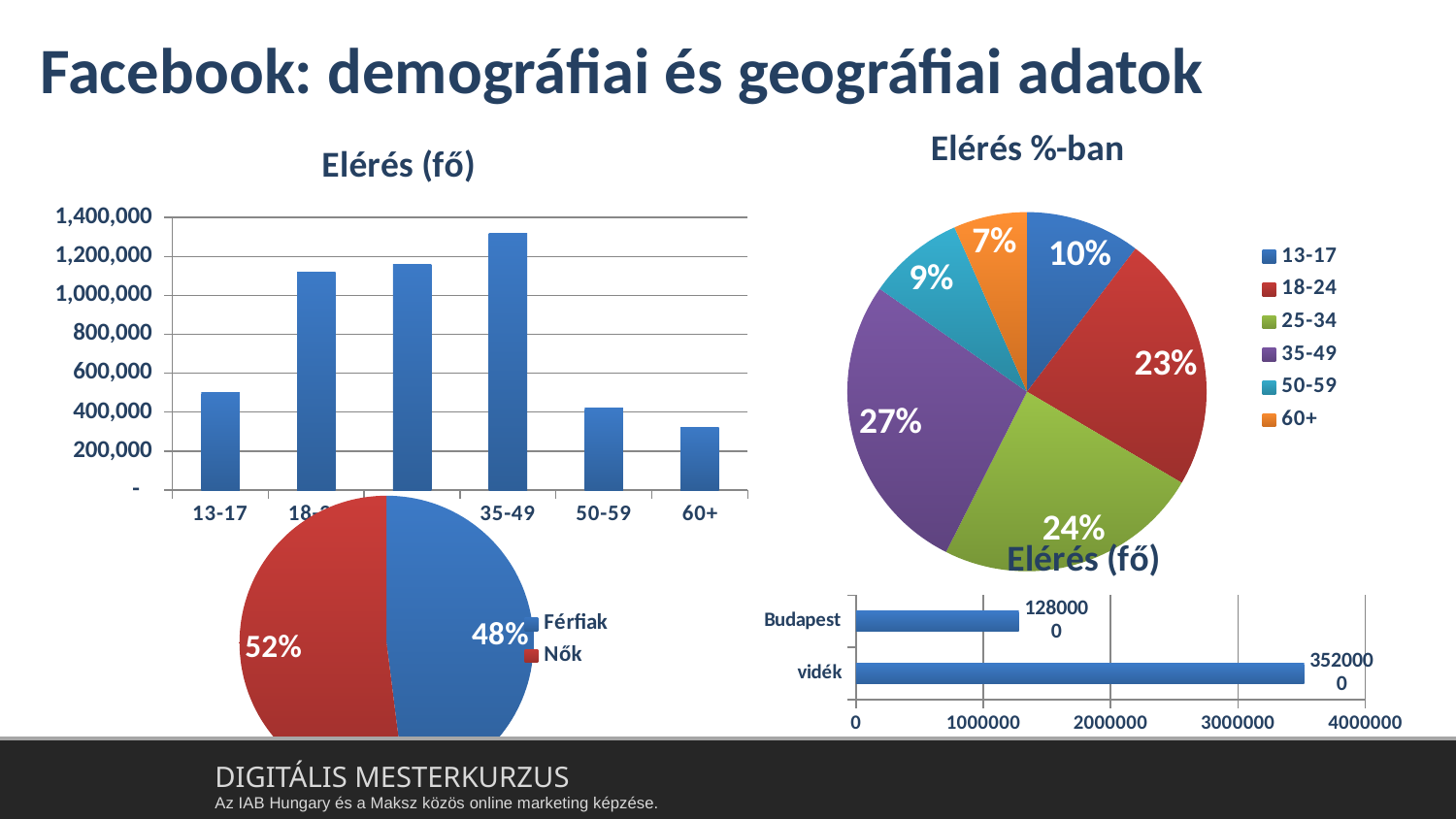
In the pie chart titled 'Elérés %-ban', what share does the 35-49 group have? 27% In the top-left bar chart titled 'Elérés (fő)', which age group has the highest value? 35-49 In the top-left bar chart titled 'Elérés (fő)', how many age groups are shown on the x axis? 6 In the pie chart titled 'Elérés %-ban', which age group has the smallest slice? 60+ In the bottom-right chart titled 'Elérés (fő)', which is larger, Budapest or vidék? vidék In the pie chart titled 'Elérés %-ban', how many entries does the legend list? 6 In the bottom-right chart titled 'Elérés (fő)', what is the value for vidék? 3520000 In the top-left bar chart titled 'Elérés (fő)', is the value for 60+ greater or less than 400,000? less In the pie chart titled 'Elérés %-ban', what is the difference in percentage points between the 18-24 and 13-17 slices? 13 In the bottom-left pie chart, what share is labelled for Nők? 52% In the top-left bar chart titled 'Elérés (fő)', which age group has the lowest value? 60+ In the top-left bar chart titled 'Elérés (fő)', is the value for 35-49 greater or less than 1,200,000? greater